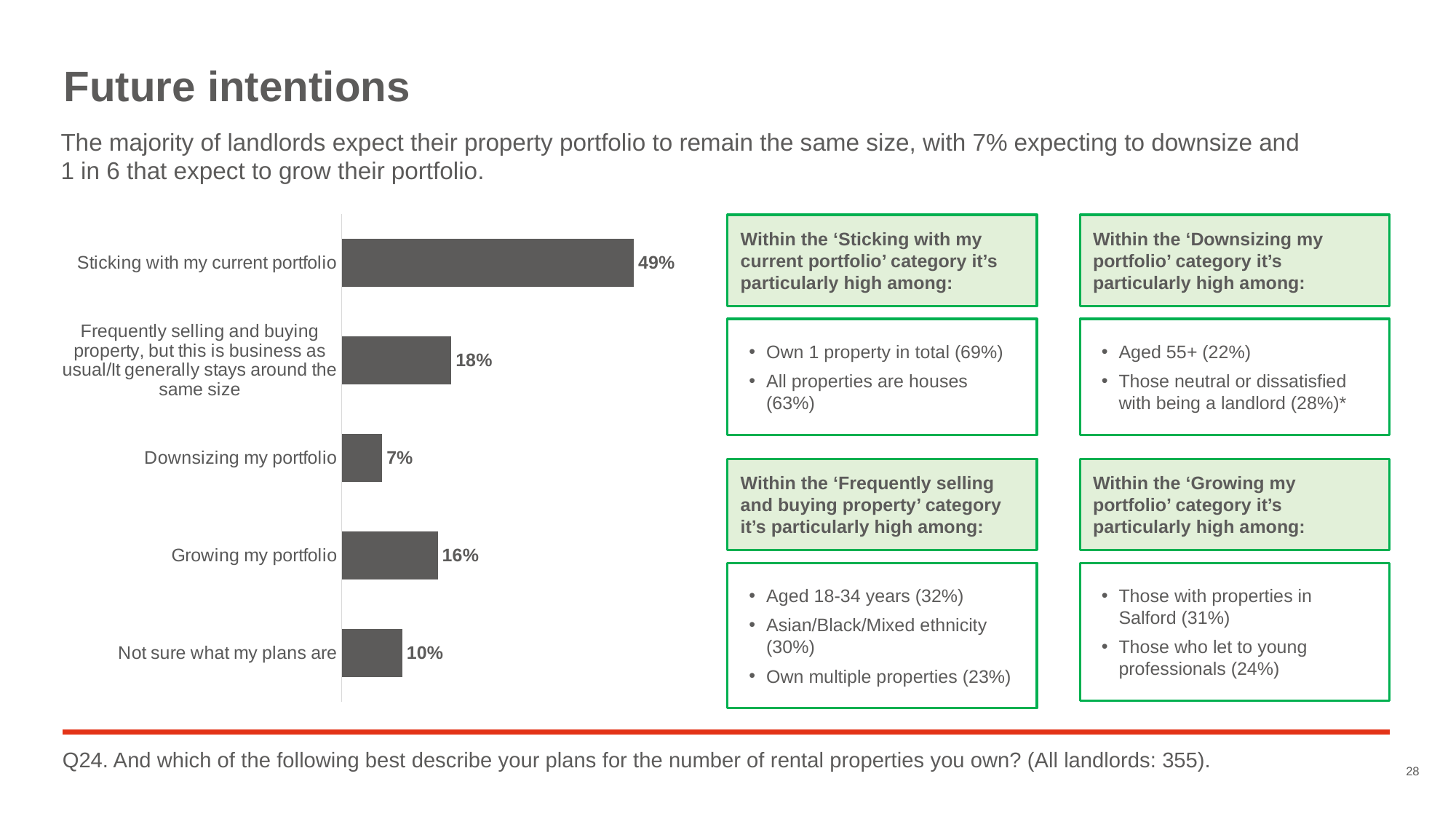
What percentage of landlords say they are sticking with their current portfolio? 49% What percentage of landlords say they are growing their portfolio? 16% Which category has the highest value in the chart? Sticking with my current portfolio What type of chart is shown on the slide? Bar chart What percentage of landlords say they are frequently selling and buying property as business as usual? 18% What is the difference between the value for 'Sticking with my current portfolio' and the value for 'Growing my portfolio'? 33% What percentage of landlords say they are downsizing their portfolio? 7% What percentage of landlords are not sure what their plans are? 10% How many categories are shown in the chart? 5 Which category has the lowest value in the chart? Downsizing my portfolio Which is larger: the value for 'Growing my portfolio' or the value for 'Not sure what my plans are'? Growing my portfolio What is the difference between the value for 'Frequently selling and buying property' and the value for 'Downsizing my portfolio'? 11%